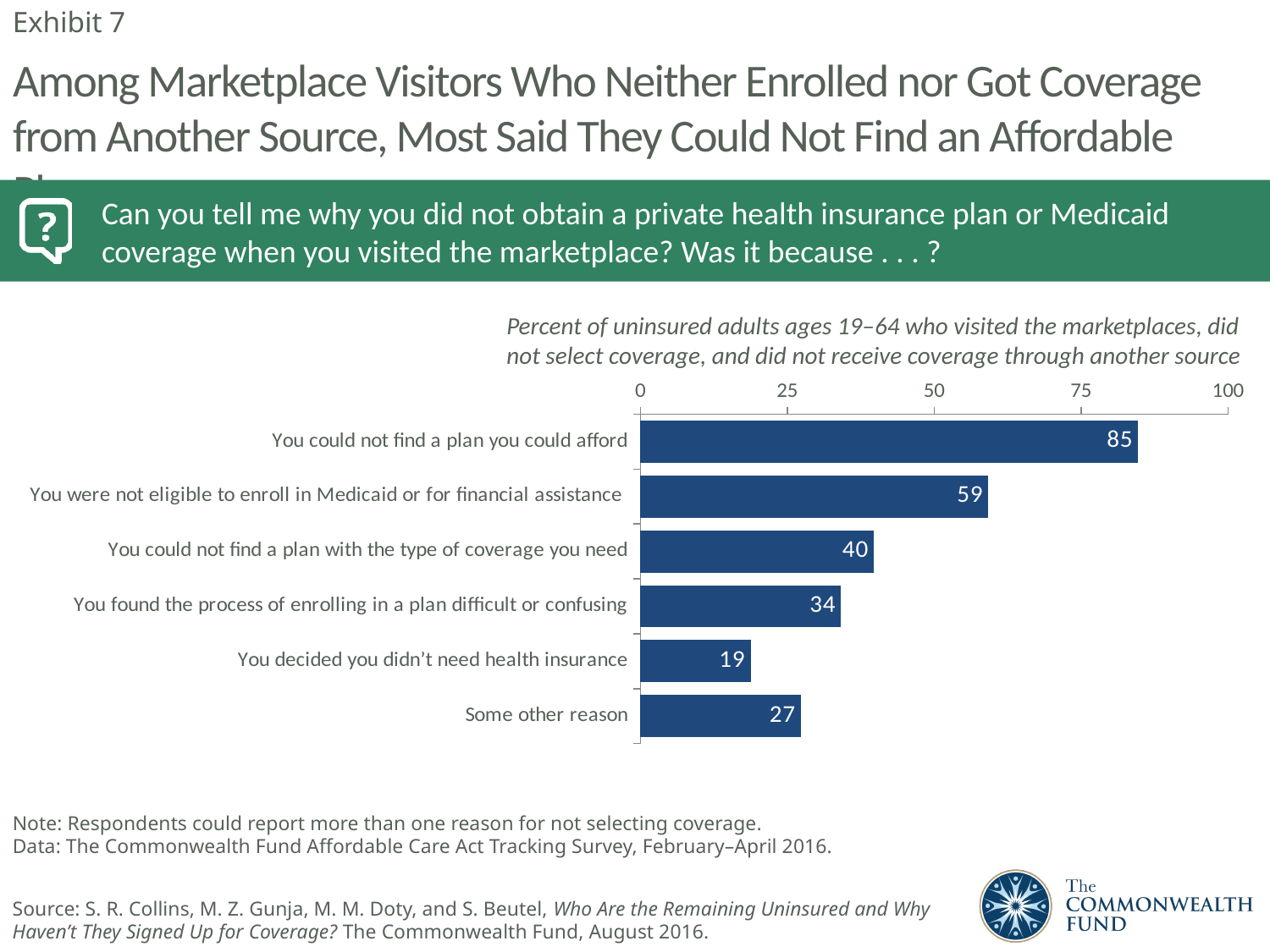
Which is larger: the value for "You could not find a plan with the type of coverage you need" or "You found the process of enrolling in a plan difficult or confusing"? You could not find a plan with the type of coverage you need Which reason has the highest value? You could not find a plan you could afford How many reasons (categories) are shown in the chart? 6 Is the value for "You found the process of enrolling in a plan difficult or confusing" greater or less than 50? less What percent of respondents said they could not find a plan they could afford? 85 What is the maximum value shown on the chart's axis? 100 What kind of chart is shown on the slide? Bar chart What is the value for "You decided you didn't need health insurance"? 19 What is the difference between the values for "You could not find a plan you could afford" and "You were not eligible to enroll in Medicaid or for financial assistance"? 26 What is the value for "Some other reason"? 27 What is the value for "You were not eligible to enroll in Medicaid or for financial assistance"? 59 Which reason has the lowest value? You decided you didn't need health insurance